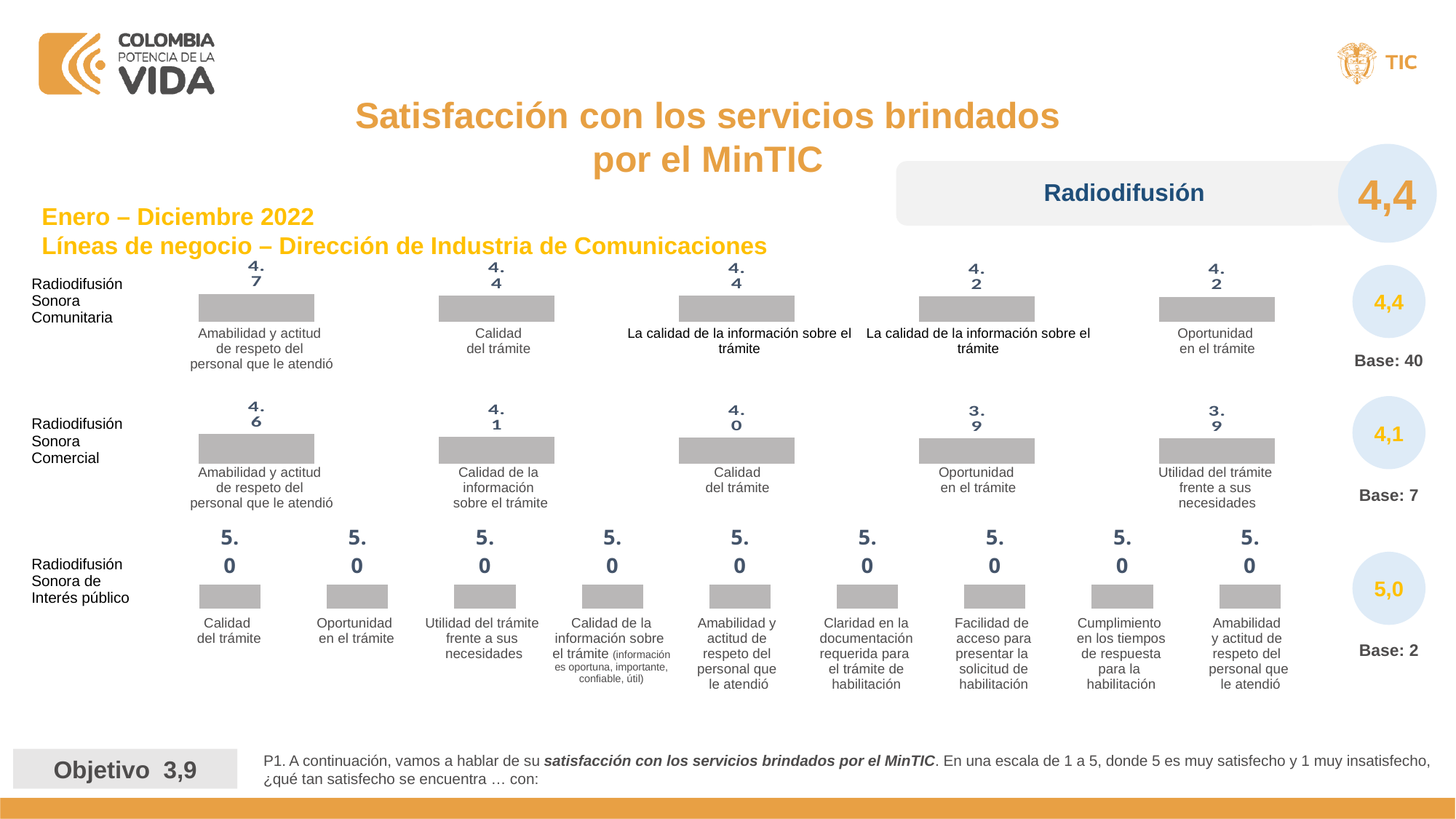
In the Radiodifusión Sonora de Interés público chart, how many categories are plotted? 9 In the Radiodifusión Sonora Comercial chart, how many categories are plotted? 5 In the Radiodifusión Sonora Comunitaria chart, what is the value for 'Amabilidad y actitud de respeto del personal que le atendió'? 4.7 In the Radiodifusión Sonora Comunitaria chart, what is the value for 'Oportunidad en el trámite'? 4.2 What is the overall Radiodifusión score shown in the large circle at the top right of the slide? 4,4 In the Radiodifusión Sonora Comercial chart, which is larger: 'Calidad del trámite' or 'Oportunidad en el trámite'? Calidad del trámite In the Radiodifusión Sonora de Interés público chart, what is the value for 'Cumplimiento en los tiempos de respuesta para la habilitación'? 5.0 In the Radiodifusión Sonora Comunitaria chart, which category has the highest value? Amabilidad y actitud de respeto del personal que le atendió In the Radiodifusión Sonora Comercial chart, what is the value for 'Calidad de la información sobre el trámite'? 4.1 In the Radiodifusión Sonora Comercial chart, what is the difference between 'Amabilidad y actitud de respeto del personal que le atendió' and 'Calidad del trámite'? 0.6 What kind of chart is used for the Radiodifusión Sonora Comunitaria row? Bar chart In the Radiodifusión Sonora Comunitaria chart, what is the difference between 'Amabilidad y actitud de respeto del personal que le atendió' and 'Calidad del trámite'? 0.3